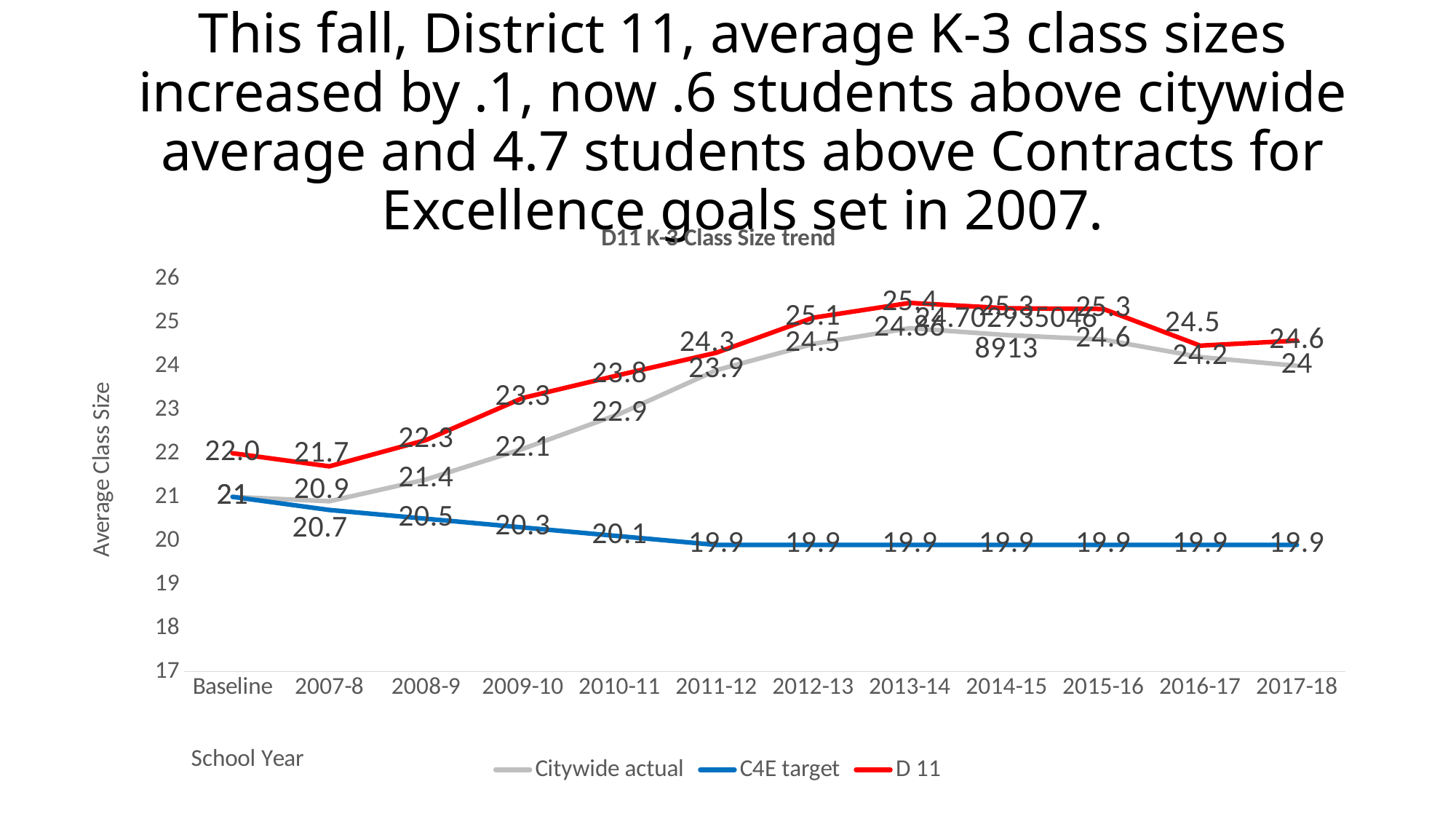
How many series does the legend list? 3 What is the D 11 value at Baseline? 22.0 What is the C4E target value for 2017-18? 19.9 What is the difference between the D 11 value and the Citywide actual value in 2017-18? 0.6 In which school year is the D 11 value lowest? 2007-8 What is the Citywide actual value for 2011-12? 23.9 What is the difference between the D 11 value and the C4E target value in 2017-18? 4.7 What kind of chart is shown on the slide? Line chart In 2009-10, which is larger: the D 11 value or the Citywide actual value? D 11 What is the D 11 value for 2017-18? 24.6 How many school years are plotted on the x axis? 12 In which school year is the D 11 value highest? 2013-14